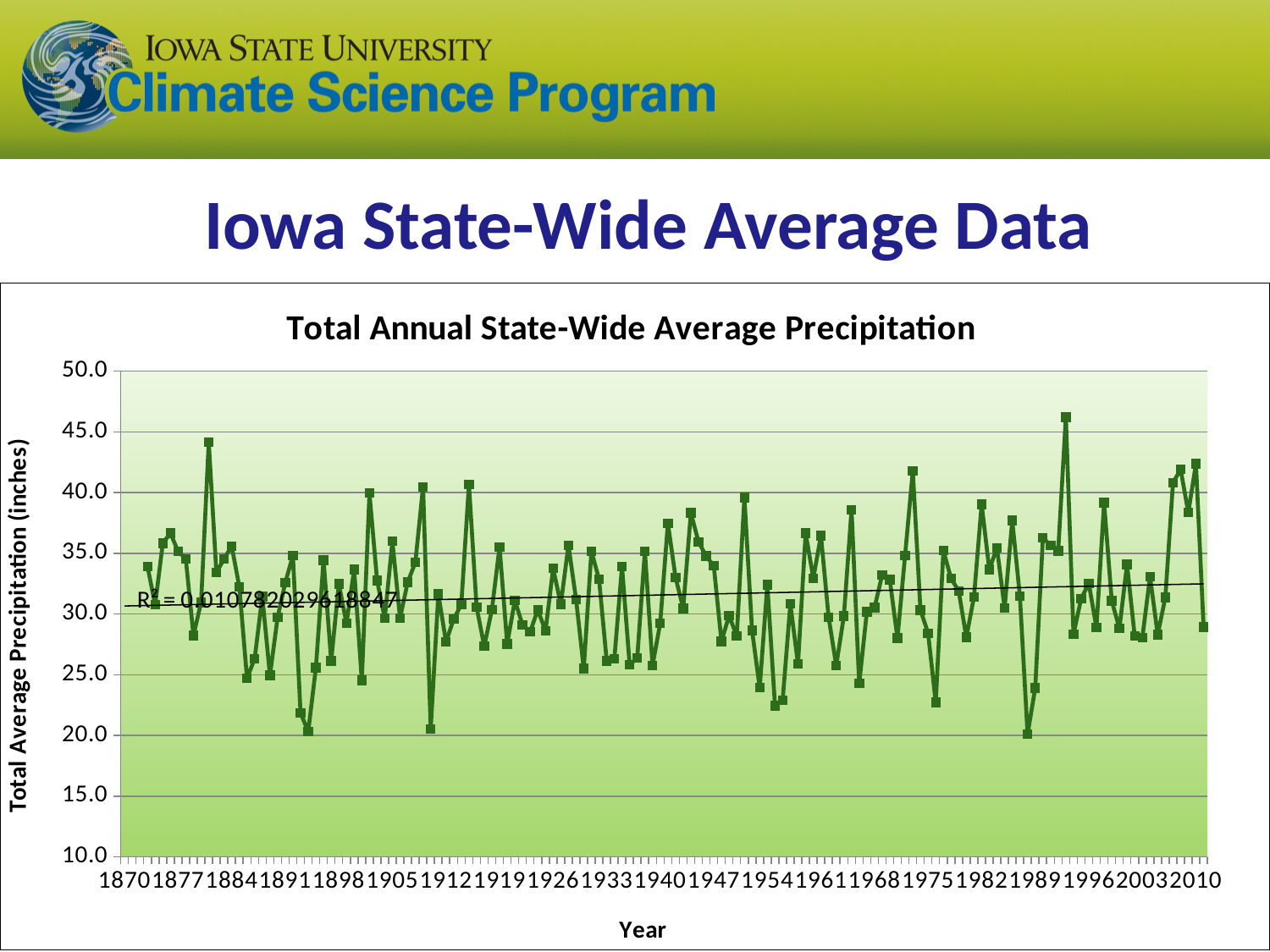
Is the value for 2010 greater or less than 35.0? greater What is the title of the chart? Total Annual State-Wide Average Precipitation Is the lowest value plotted on the chart greater or less than 25.0? less Is the highest value plotted on the chart greater or less than 45.0? greater Does the trendline on the chart rise or fall from 1870 to 2010? rises slightly What kind of chart is shown on the slide? line chart What R² value is printed on the chart? R² = 0.010782029618847